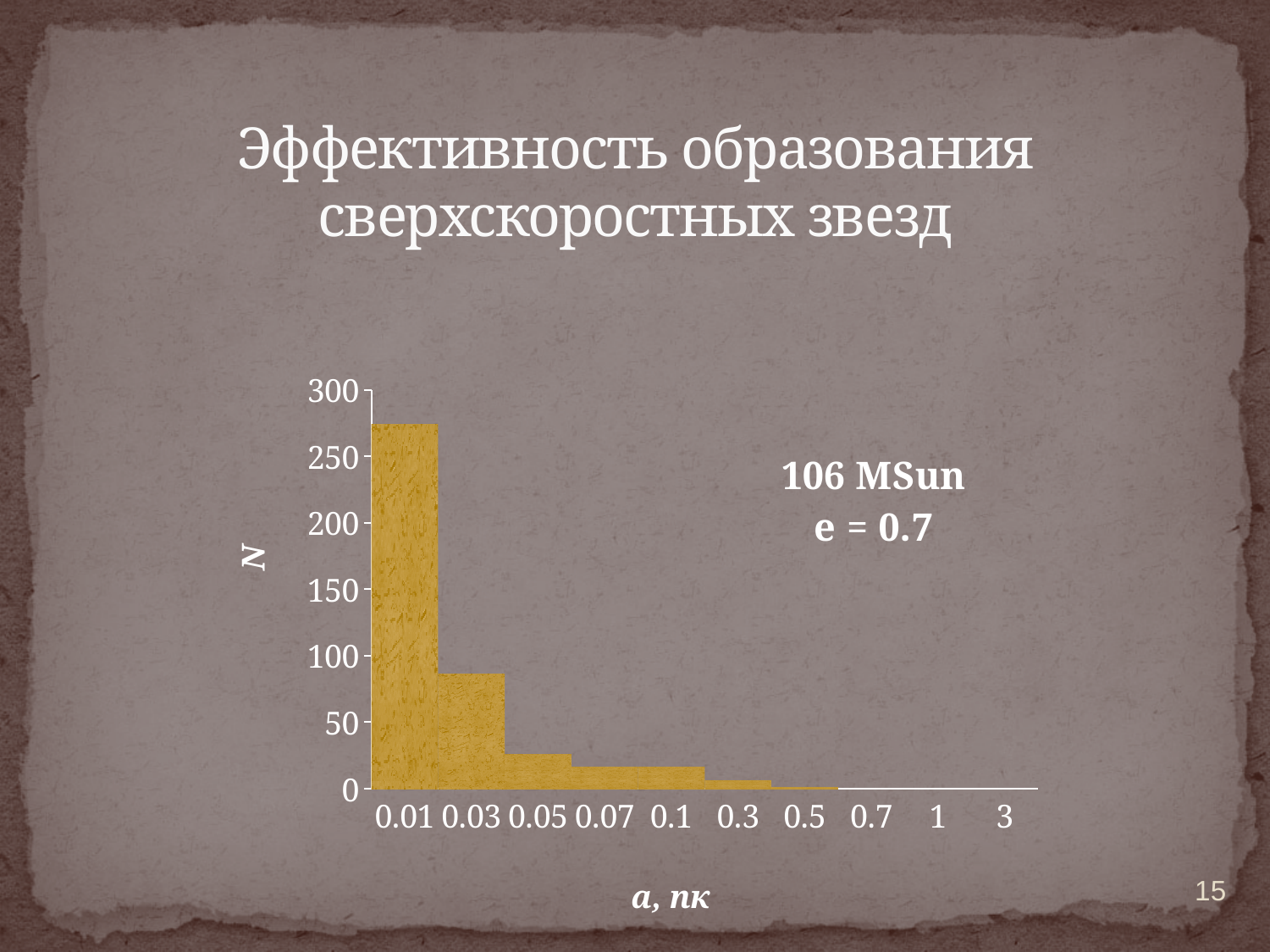
Which has a larger value of N: a = 0.01 or a = 0.03? 0.01 Do the values of N rise or fall as a increases along the x axis? fall Is the value of N for a = 0.05 greater or less than 50? less Which has a larger value of N: a = 0.05 or a = 0.1? 0.05 What kind of chart is shown on the slide? bar chart How many categories are shown on the x axis of the chart? 10 What is the label of the x axis of the chart? a, пк Is the value of N for a = 0.01 greater or less than 250? greater Is the value of N for a = 0.03 greater or less than 50? greater What value of e is given in the annotation on the chart? 0.7 Which category on the x axis has the highest value of N? 0.01